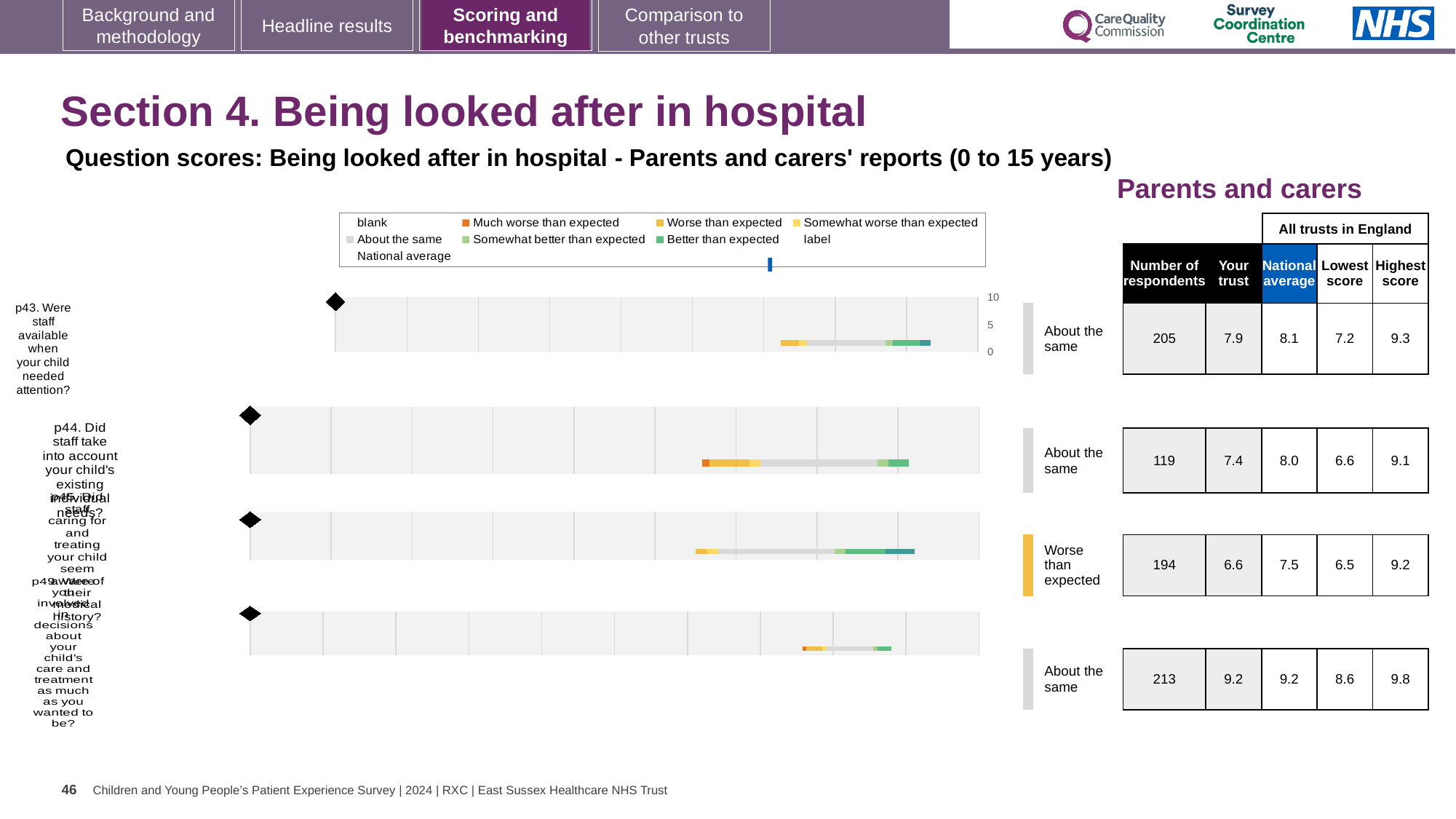
For p43, what is the difference between the highest score and the lowest score across all trusts in England? 2.1 What is the highest score across all trusts in England for p49? 9.8 Which question has the lowest 'Your trust' score? p45 What is the 'Your trust' score for p43 (Were staff available when your child needed attention?)? 7.9 Which has the higher 'Your trust' score, p43 or p44? p43 Which question has the highest 'Your trust' score? p49 How many respondents are shown for question p45? 194 How many questions (rows) are plotted in the chart? 4 What kind of chart is used to show the question scores on this slide? bar chart For p45, what is the difference between the national average and the 'Your trust' score? 0.9 What does the blue marker in the chart legend represent? National average What benchmark category is shown for question p45? Worse than expected